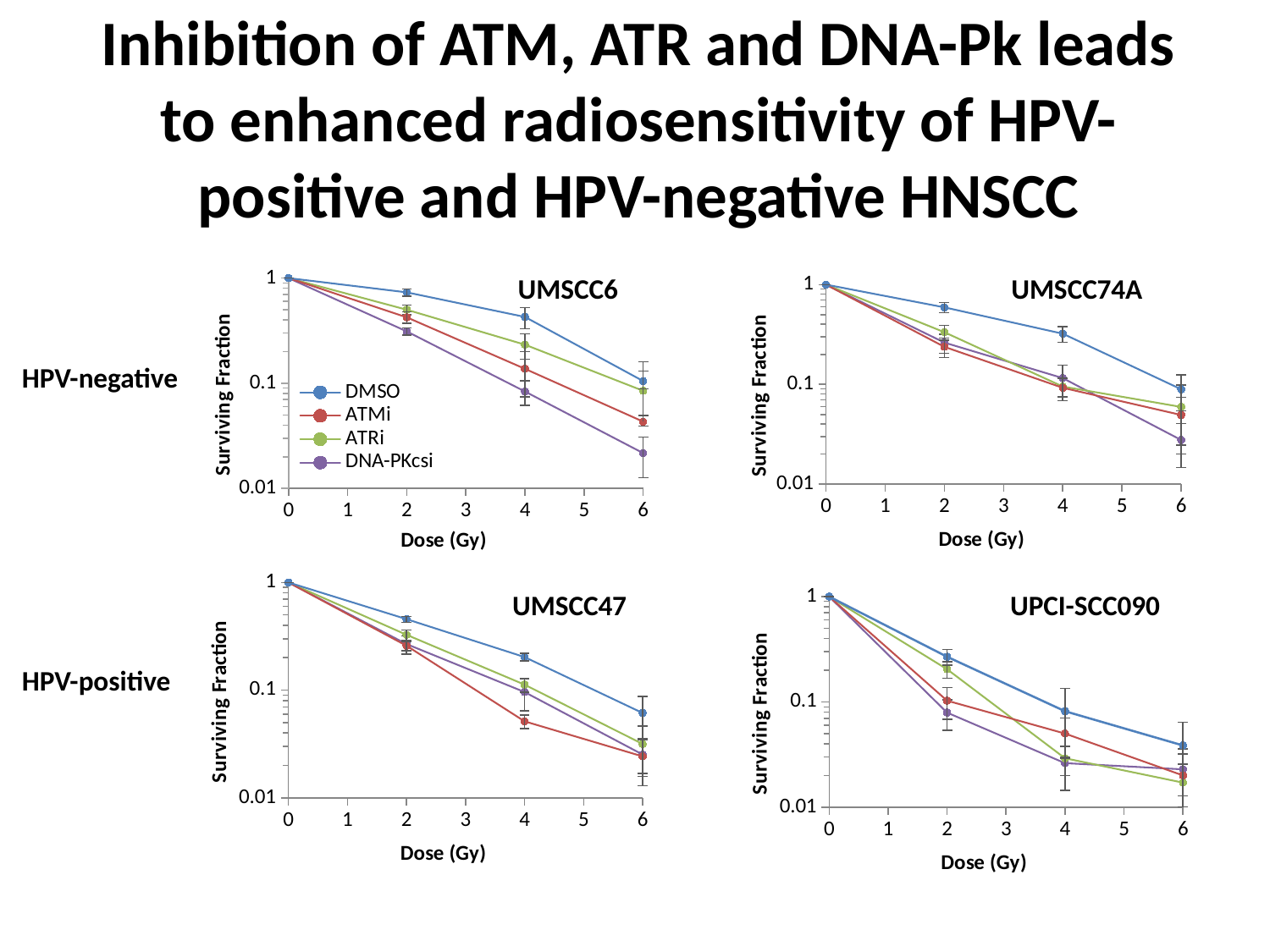
In the UMSCC6 chart, which series has the lowest surviving fraction at 6 Gy? DNA-PKcsi How many series does the legend on the UMSCC6 chart list? 4 What kind of chart is the UMSCC6 chart? line chart How many dose points are plotted for each series in the UMSCC47 chart? 4 In the UMSCC74A chart, is the DMSO value at 4 Gy greater or less than 0.1? greater In the UMSCC47 chart, which is larger at 4 Gy, the DMSO value or the ATMi value? DMSO In the UPCI-SCC090 chart, is the DMSO value at 2 Gy greater or less than 0.1? greater In the UMSCC6 chart, is the DNA-PKcsi value at 6 Gy greater or less than 0.1? less What are the legend entries on the UMSCC6 chart? DMSO, ATMi, ATRi, DNA-PKcsi In the UMSCC6 chart, does the DMSO surviving fraction rise or fall as the dose increases? fall In the UMSCC74A chart, which series has the lowest surviving fraction at 6 Gy? DNA-PKcsi